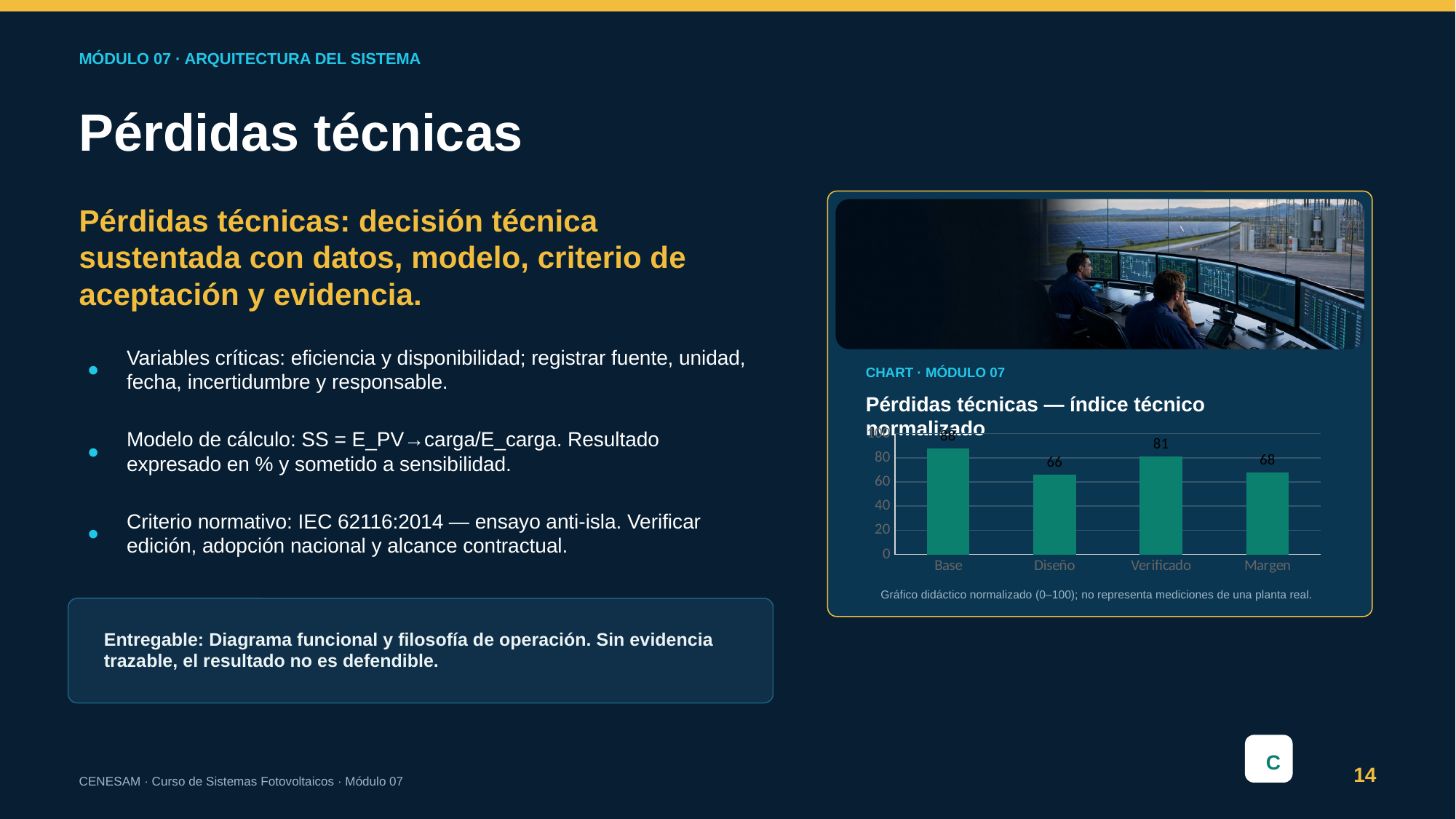
What is the value for Margen in the chart? 68 What is the difference between the values for Verificado and Diseño? 15 What kind of chart is shown on the slide? bar chart What is the difference between the values for Verificado and Margen? 13 Is the value for Base greater or less than 80? greater Is the value for Diseño greater or less than 80? less How many categories are shown on the x axis of the chart? 4 What is the value for Diseño in the chart? 66 What is the title of the chart? Pérdidas técnicas — índice técnico normalizado Which category has the highest value in the chart? Base Which is larger, the value for Verificado or the value for Diseño? Verificado What is the value for Verificado in the chart? 81